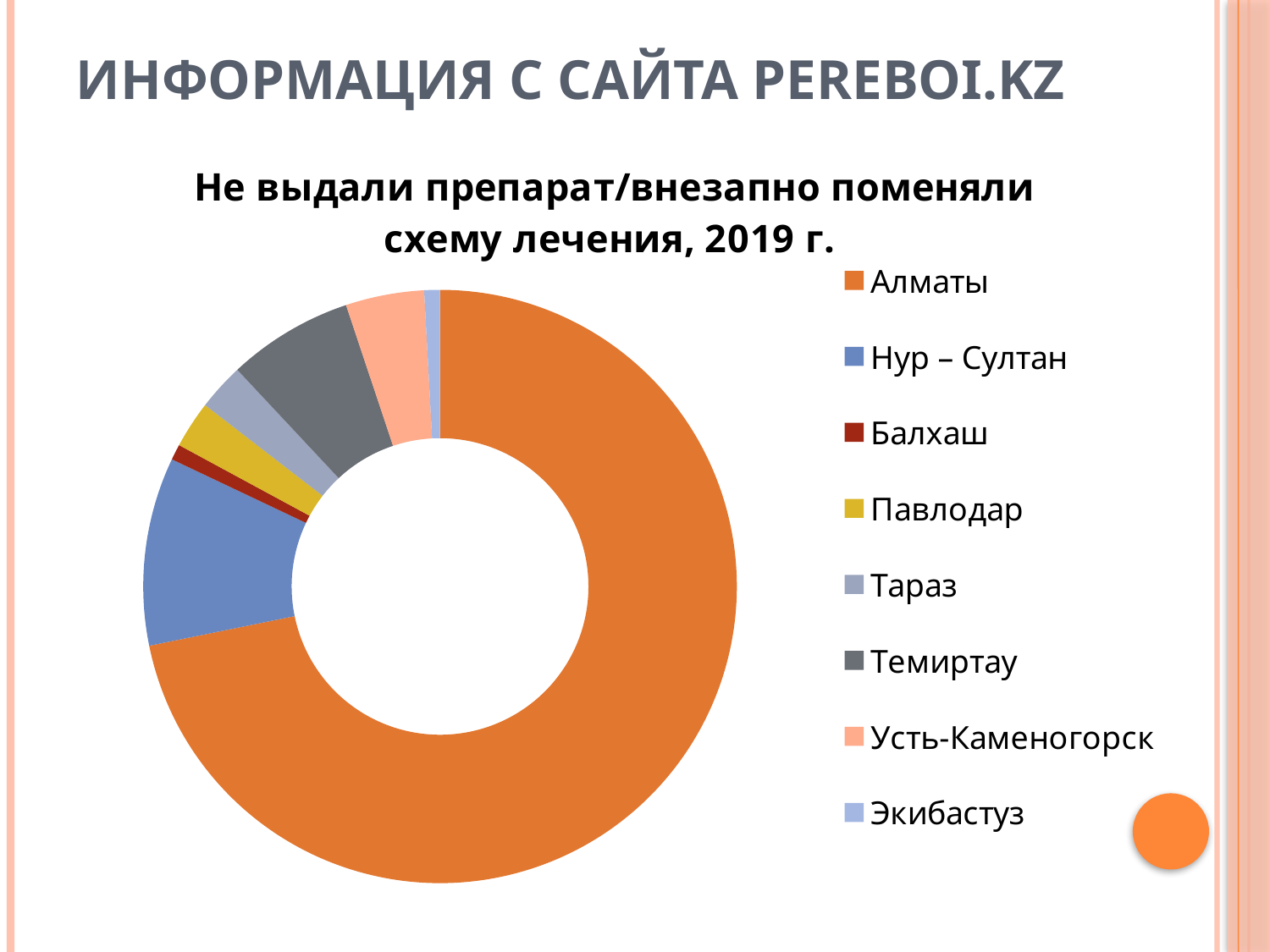
Which slice is larger, Нур – Султан or Балхаш? Нур – Султан What is the title of the chart? Не выдали препарат/внезапно поменяли схему лечения, 2019 г. What kind of chart is shown on the slide? Doughnut (pie) chart Which slice is larger, Темиртау or Тараз? Темиртау How many categories does the chart's legend list? 8 Which slice is larger, Павлодар or Балхаш? Павлодар What colour represents Алматы in the chart? Orange Does the Алматы slice make up more or less than half of the chart? More Which category has the largest slice of the chart? Алматы